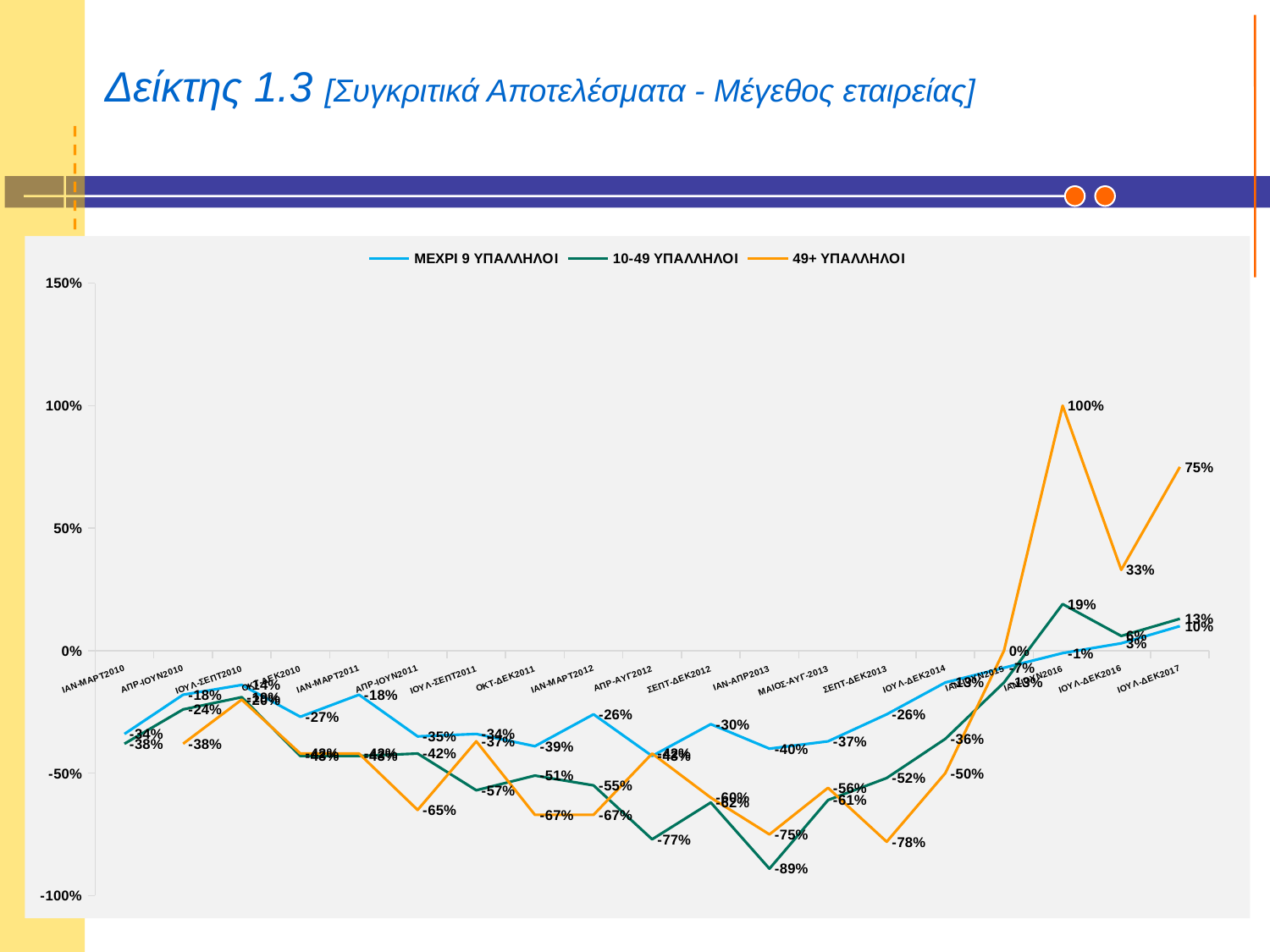
How many series does the chart legend list? 3 By how many percentage points does the 49+ ΥΠΑΛΛΗΛΟΙ series fall from ΙΑΝ-ΙΟΥΝ2016 (100%) to ΙΟΥΛ-ΔΕΚ2016 (33%)? 67 percentage points In which period does the 49+ ΥΠΑΛΛΗΛΟΙ series reach its peak of 100%? ΙΑΝ-ΙΟΥΝ2016 Which series has the highest value at ΙΟΥΛ-ΔΕΚ2017? 49+ ΥΠΑΛΛΗΛΟΙ What is the highest value reached by the 49+ ΥΠΑΛΛΗΛΟΙ series? 100% What colour is the line for the 49+ ΥΠΑΛΛΗΛΟΙ series? Orange What is the lowest value reached by the 10-49 ΥΠΑΛΛΗΛΟΙ series? -89% What type of chart is shown on the slide? Line chart What is the value of the 10-49 ΥΠΑΛΛΗΛΟΙ series for ΙΑΝ-ΙΟΥΝ2016? 19% What is the value of the 49+ ΥΠΑΛΛΗΛΟΙ series for ΙΟΥΛ-ΔΕΚ2017? 75% What is the value of the 49+ ΥΠΑΛΛΗΛΟΙ series for ΙΟΥΛ-ΔΕΚ2016? 33% How many periods are shown on the x axis of the chart? 19